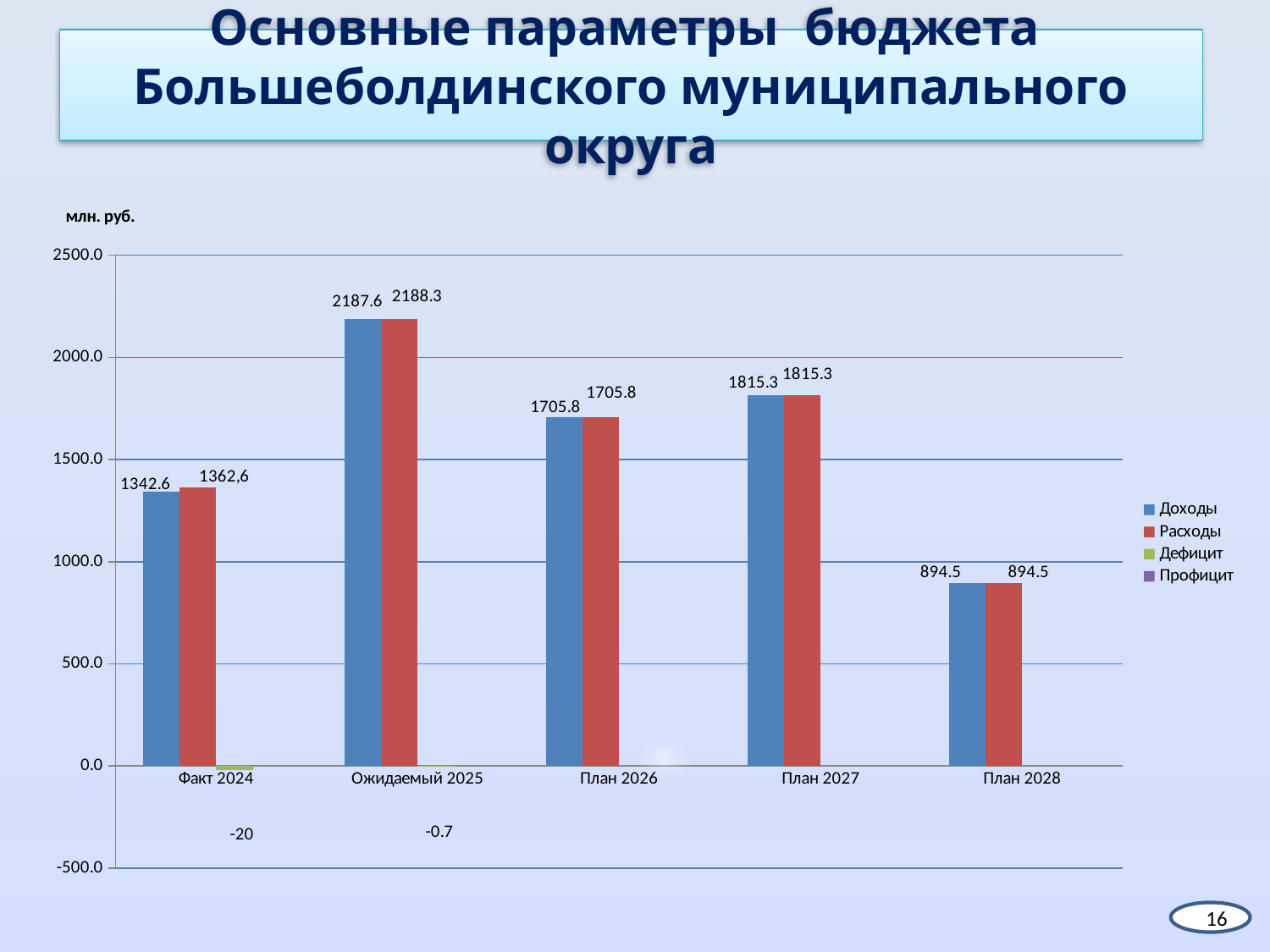
What is the difference between Доходы for План 2027 and Доходы for План 2026? 109.5 Which category has the lowest value of Расходы? План 2028 What kind of chart is shown on the slide? bar chart What is the value of Дефицит for Факт 2024? -20 What is the value of Доходы for План 2028? 894.5 Which is larger: Доходы for Факт 2024 or Доходы for План 2028? Доходы for Факт 2024 Is the value of Расходы for План 2026 greater or less than 1500.0? greater What is the value of Расходы for Факт 2024? 1362,6 What is the value of Доходы for Ожидаемый 2025? 2187.6 How many series does the legend list? 4 How many categories are shown on the x axis? 5 Which category has the highest value of Доходы? Ожидаемый 2025